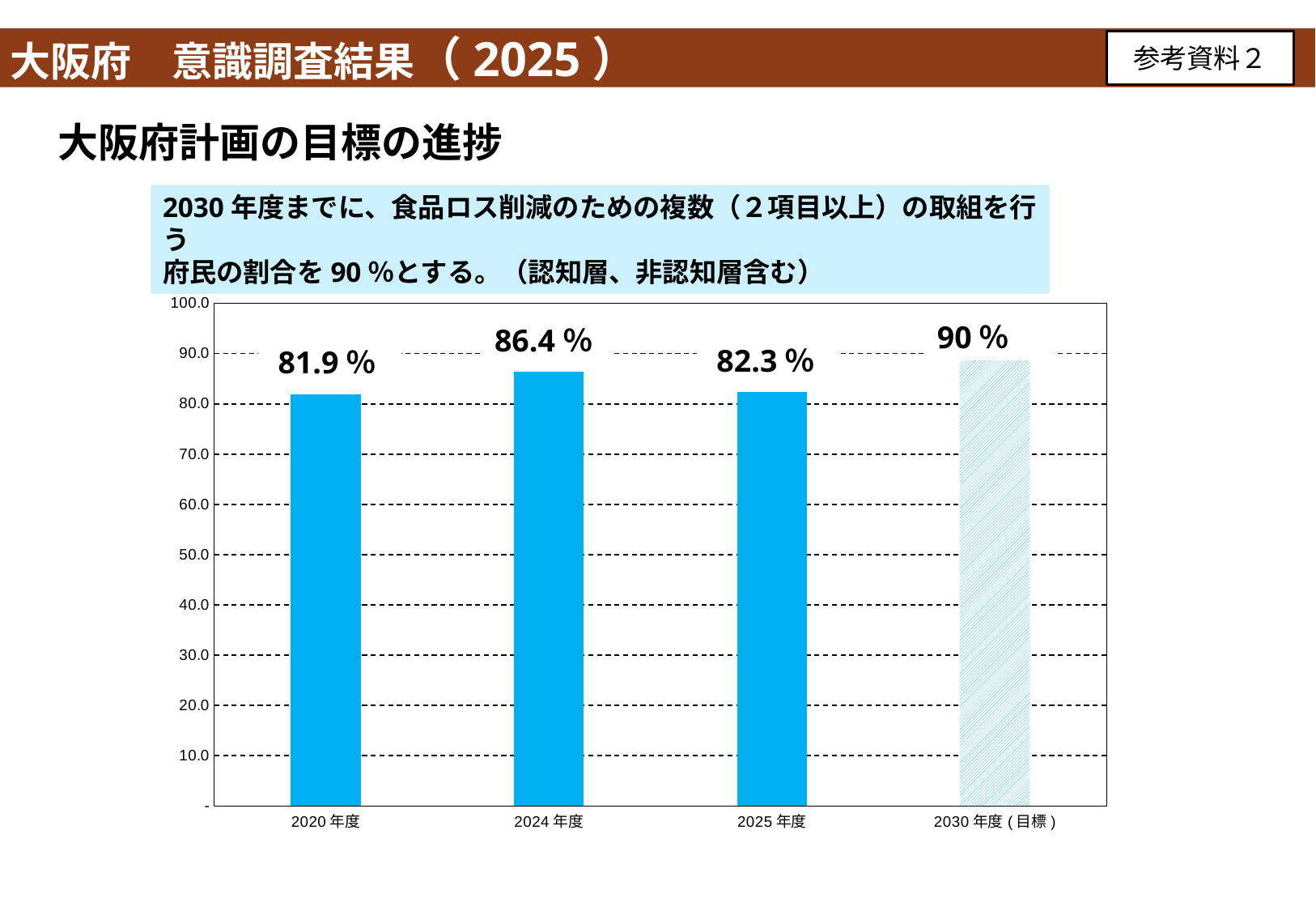
Which category has the highest value? 2030年度(目標) What kind of chart is shown on the slide? Bar chart What is the value shown for 2024年度? 86.4% What is the difference between the values for 2024年度 and 2020年度? 4.5% Which is larger, the value for 2024年度 or the value for 2025年度? 2024年度 What is the value shown for 2030年度(目標)? 90% What is the difference between the 2030年度(目標) value and the 2025年度 value? 7.7% What is the value shown for 2025年度? 82.3% What is the value shown for 2020年度? 81.9% How many categories are shown on the x axis? 4 Is the value for 2025年度 greater or less than 90.0? less Which category has the lowest value? 2020年度